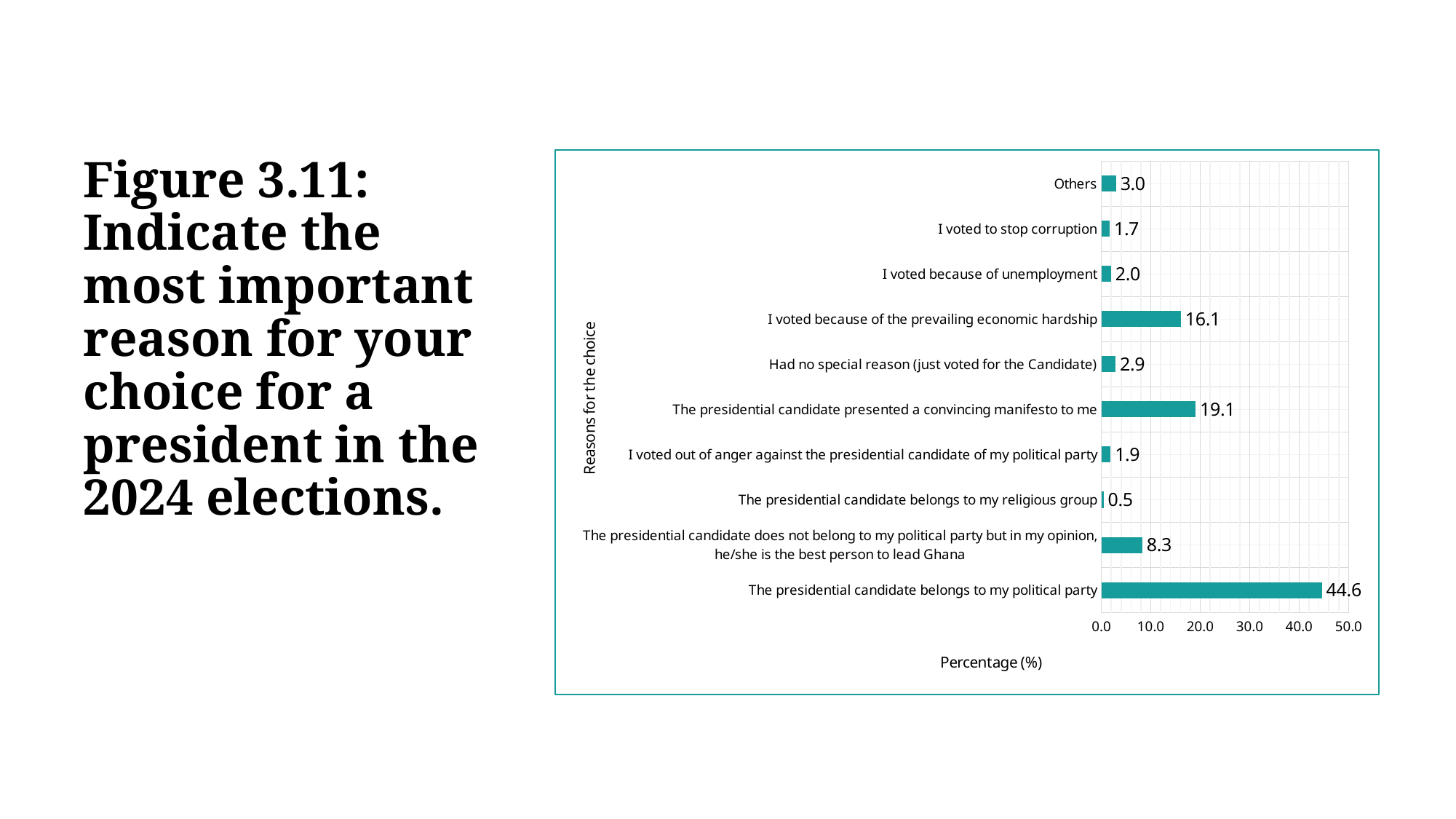
Which reason has the lowest percentage? The presidential candidate belongs to my religious group What kind of chart is shown on the slide? Bar chart What is the value for "Others"? 3.0 Is the value for "The presidential candidate belongs to my political party" greater or less than 40.0? greater What is the value for "The presidential candidate belongs to my political party"? 44.6 What is the difference between the values for "The presidential candidate belongs to my political party" and "The presidential candidate presented a convincing manifesto to me"? 25.5 How many reasons (categories) are shown in the chart? 10 Which is larger: the value for "I voted because of unemployment" or the value for "I voted to stop corruption"? I voted because of unemployment Which reason has the highest percentage? The presidential candidate belongs to my political party What is the label of the horizontal axis of the chart? Percentage (%) What is the value for "I voted because of the prevailing economic hardship"? 16.1 What is the value for "The presidential candidate presented a convincing manifesto to me"? 19.1